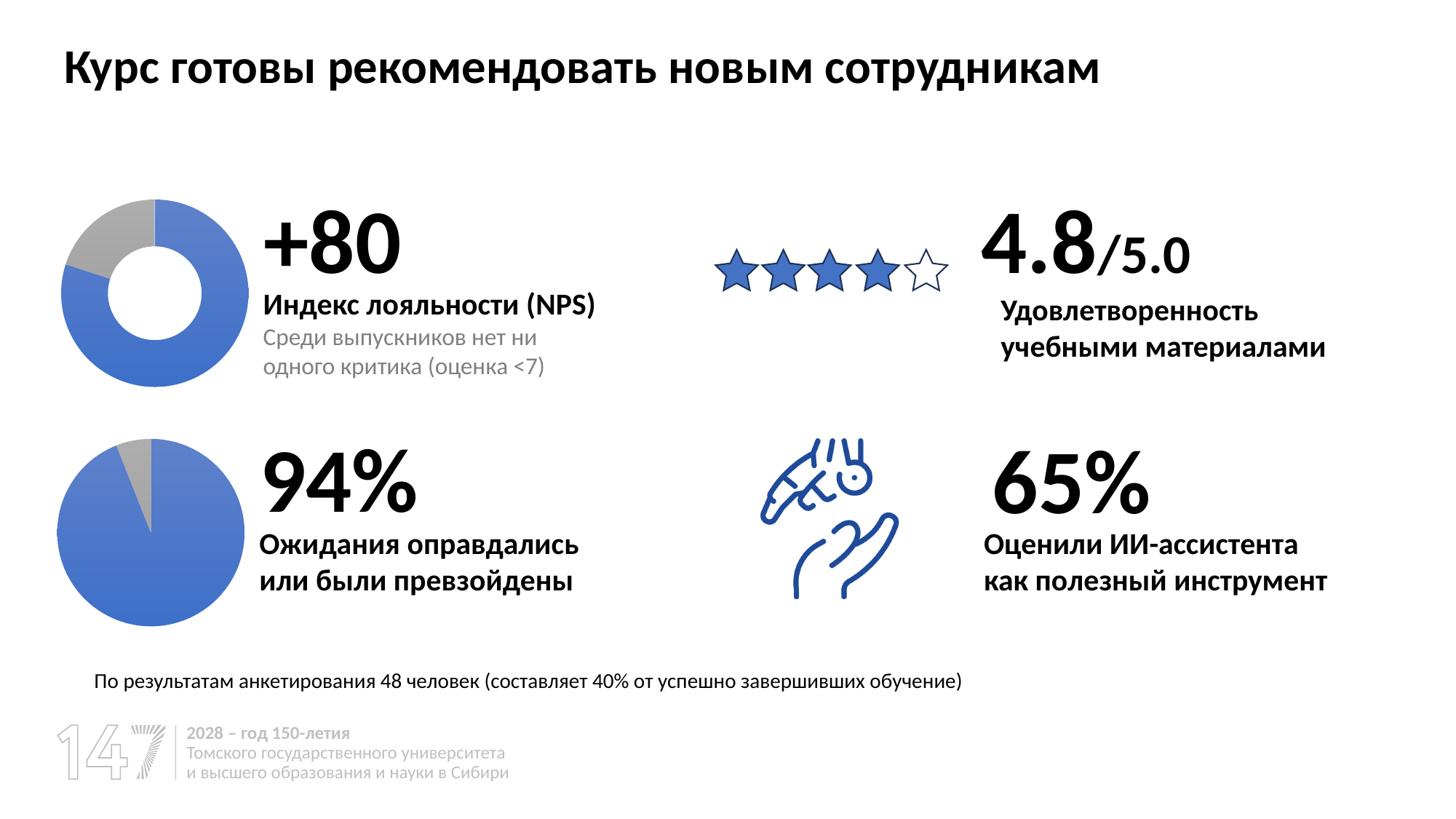
How many segments does the bottom-left pie chart have? 2 What percentage is printed next to the bottom-left pie chart for expectations met or exceeded? 94% In the bottom-left pie chart, which slice is larger, the blue one or the grey one? blue According to the footnote, how many people were surveyed for the results shown in the charts? 48 How many segments does the top-left donut chart have? 2 What metric name is printed under the +80 value next to the top-left donut chart? Индекс лояльности (NPS) What value is printed next to the top-left donut chart for the loyalty index (NPS)? +80 What kind of chart is shown at the bottom left of the slide, next to the 94% figure? pie chart What satisfaction score for learning materials is printed next to the star rating? 4.8/5.0 What kind of chart is shown at the top left of the slide, next to the NPS figure? donut chart In the top-left donut chart, which segment is larger, the blue one or the grey one? blue How many of the five stars in the star rating are filled in blue? 4